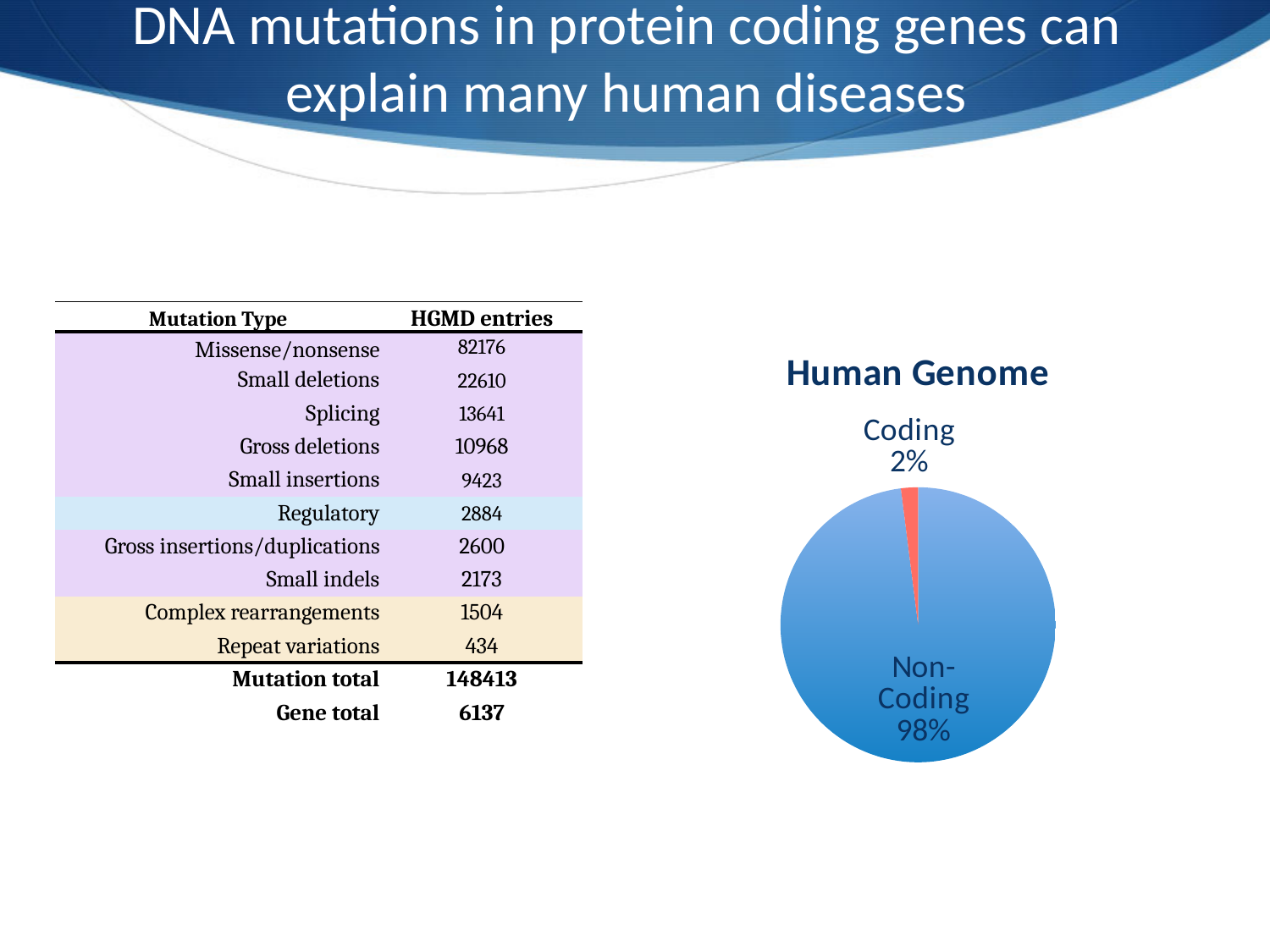
In the "Human Genome" pie chart, what share of the genome is Non-Coding? 98% In the "Human Genome" pie chart, what is the difference in percentage points between the Non-Coding and Coding slices? 96 In the "Human Genome" pie chart, which slice is the largest? Non-Coding What kind of chart is the "Human Genome" chart? pie chart In the "Human Genome" pie chart, how many slices are there? 2 In the "Human Genome" pie chart, what share of the genome is Coding? 2% In the "Human Genome" pie chart, which slice is the smallest? Coding In the "Human Genome" pie chart, what colour is the Coding slice? red What is the title of the pie chart on the slide? Human Genome In the "Human Genome" pie chart, which is larger, Coding or Non-Coding? Non-Coding